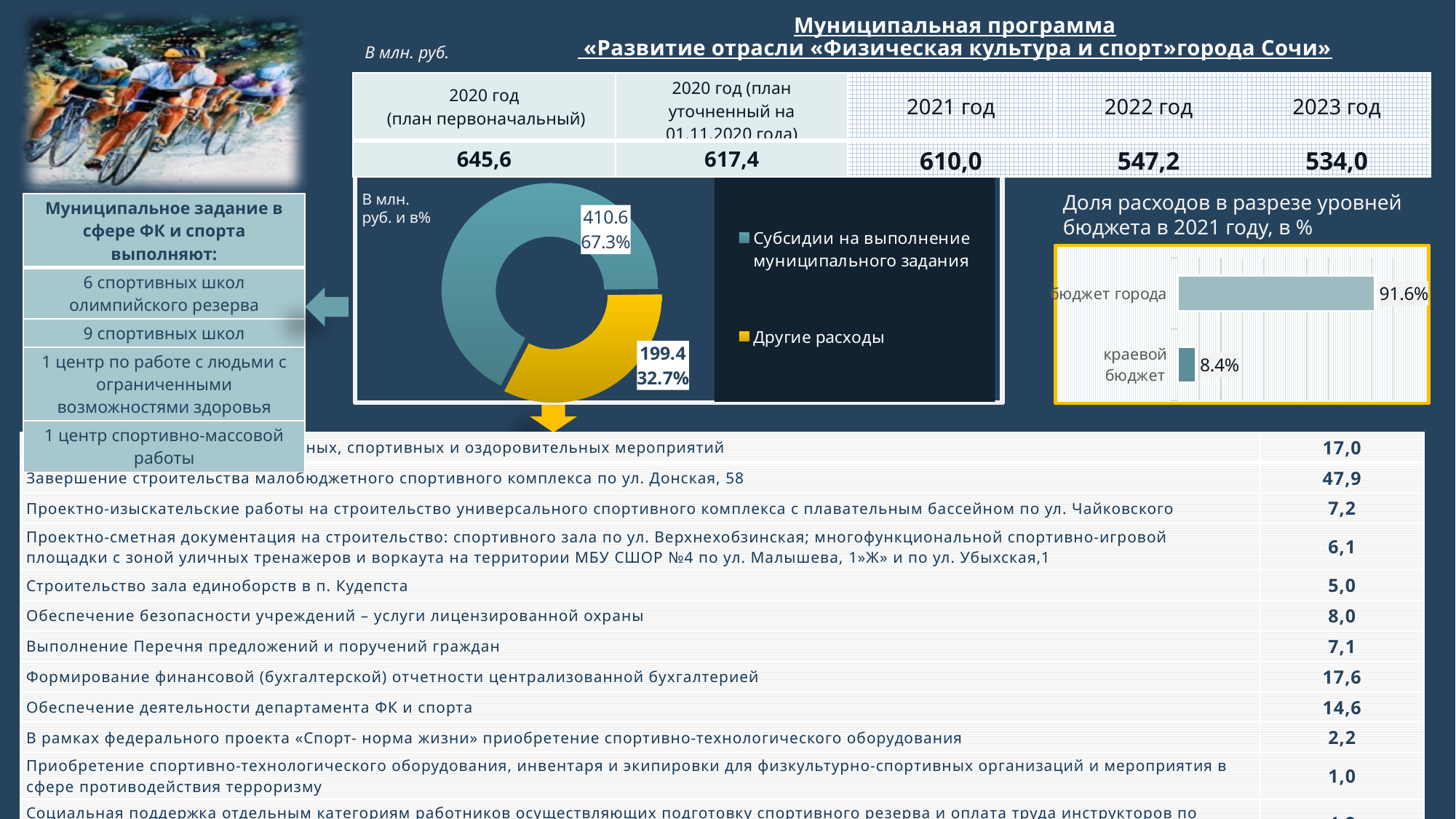
In the doughnut chart in the middle of the slide, what value is shown for «Другие расходы»? 199.4 In the chart «Доля расходов в разрезе уровней бюджета в 2021 году, в %», what value is shown for «краевой бюджет»? 8.4% In the doughnut chart in the middle of the slide, what value is shown for «Субсидии на выполнение муниципального задания»? 410.6 In the doughnut chart in the middle of the slide, which category has the larger value? Субсидии на выполнение муниципального задания In the doughnut chart in the middle of the slide, what is the difference between the values for «Субсидии на выполнение муниципального задания» and «Другие расходы»? 211.2 In the chart «Доля расходов в разрезе уровней бюджета в 2021 году, в %», what value is shown for «бюджет города»? 91.6% In the chart «Доля расходов в разрезе уровней бюджета в 2021 году, в %», which category has the lowest value? краевой бюджет How many entries does the legend of the doughnut chart in the middle of the slide list? 2 In the doughnut chart in the middle of the slide, what percentage share is shown for «Субсидии на выполнение муниципального задания»? 67.3% In the doughnut chart in the middle of the slide, what colour is the «Другие расходы» slice? Yellow In the doughnut chart in the middle of the slide, what percentage share is shown for «Другие расходы»? 32.7% What kind of chart is «Доля расходов в разрезе уровней бюджета в 2021 году, в %»? Bar chart